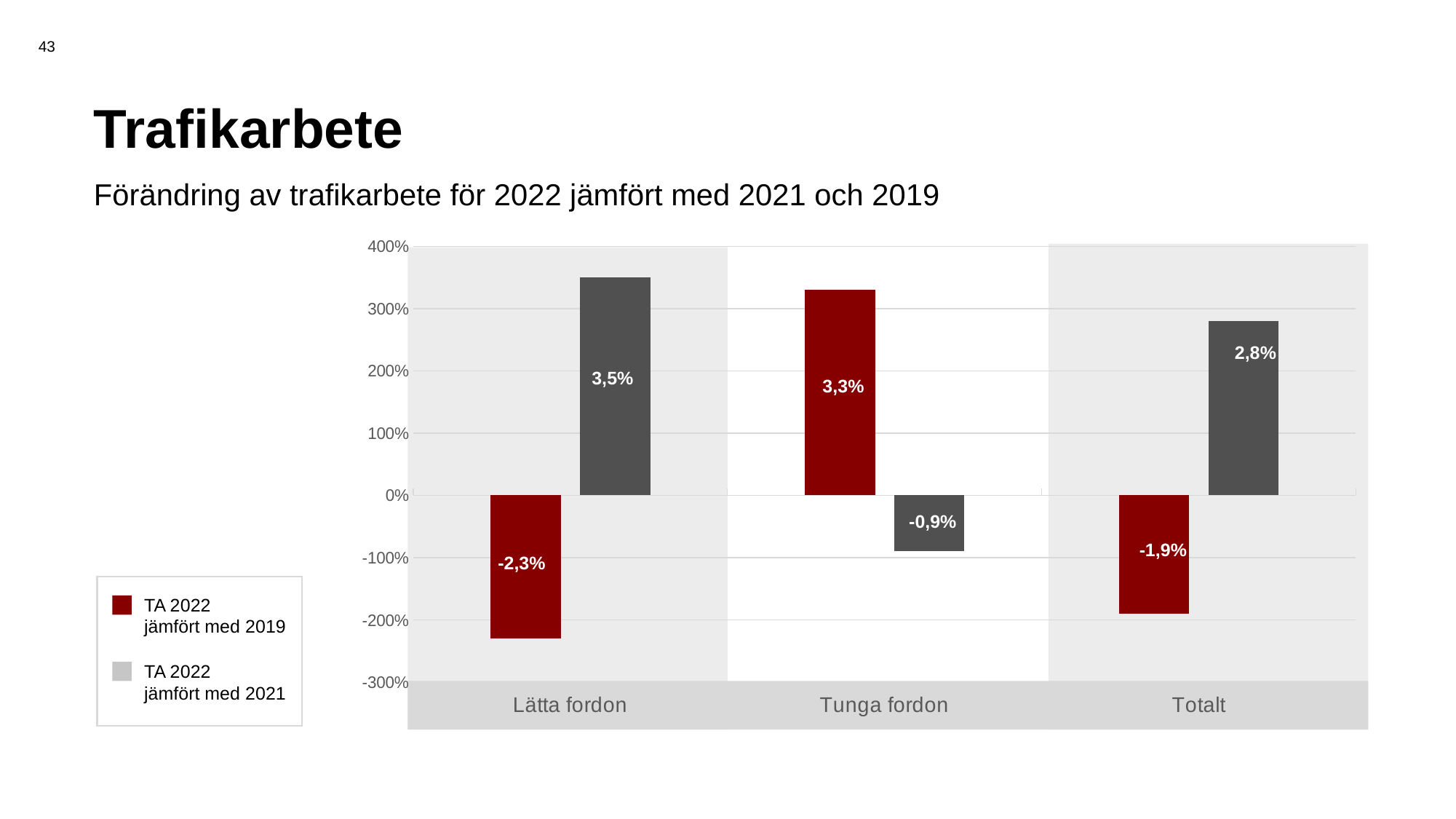
What is the difference between the TA 2022 jämfört med 2021 values for Lätta fordon and Totalt? 0,7% How many categories are shown on the x axis of the chart? 3 Which category has the highest value in the TA 2022 jämfört med 2021 series? Lätta fordon What is the value for Lätta fordon in the TA 2022 jämfört med 2019 series? -2,3% What is the value for Tunga fordon in the TA 2022 jämfört med 2019 series? 3,3% What is the value for Lätta fordon in the TA 2022 jämfört med 2021 series? 3,5% What is the value for Tunga fordon in the TA 2022 jämfört med 2021 series? -0,9% What kind of chart is shown on the slide? Bar chart How many series does the legend list? 2 Which category has the lowest value in the TA 2022 jämfört med 2019 series? Lätta fordon What is the value for Totalt in the TA 2022 jämfört med 2021 series? 2,8% For Tunga fordon, which series has the larger value: TA 2022 jämfört med 2019 or TA 2022 jämfört med 2021? TA 2022 jämfört med 2019